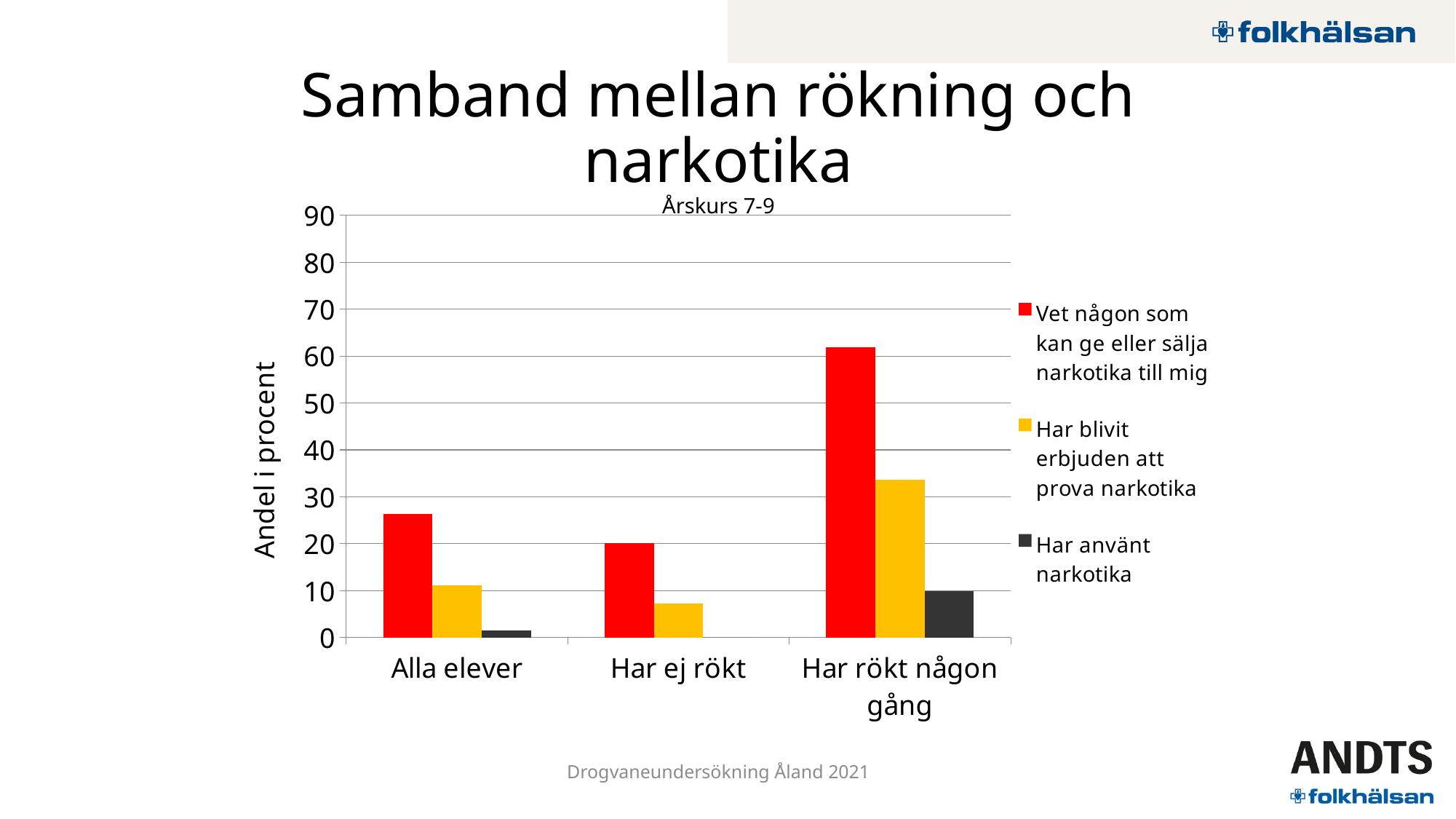
Which category has the lowest value for 'Har blivit erbjuden att prova narkotika'? Har ej rökt Which is larger: 'Vet någon som kan ge eller sälja narkotika till mig' for 'Alla elever' or for 'Har ej rökt'? Alla elever What is the subtitle shown above the chart? Årskurs 7-9 Is the value for 'Har använt narkotika' in the 'Har rökt någon gång' category greater or less than 20? less Which is larger: 'Har blivit erbjuden att prova narkotika' for 'Har rökt någon gång' or 'Vet någon som kan ge eller sälja narkotika till mig' for 'Alla elever'? Har blivit erbjuden att prova narkotika for Har rökt någon gång How many categories are shown on the x axis of the chart? 3 What is the label of the vertical axis? Andel i procent Is the value for 'Har blivit erbjuden att prova narkotika' in the 'Alla elever' category greater or less than 20? less How many series does the legend list? 3 What kind of chart is shown on the slide? bar chart Which category has the highest value for 'Vet någon som kan ge eller sälja narkotika till mig'? Har rökt någon gång Is the value for 'Vet någon som kan ge eller sälja narkotika till mig' in the 'Har rökt någon gång' category greater or less than 60? greater